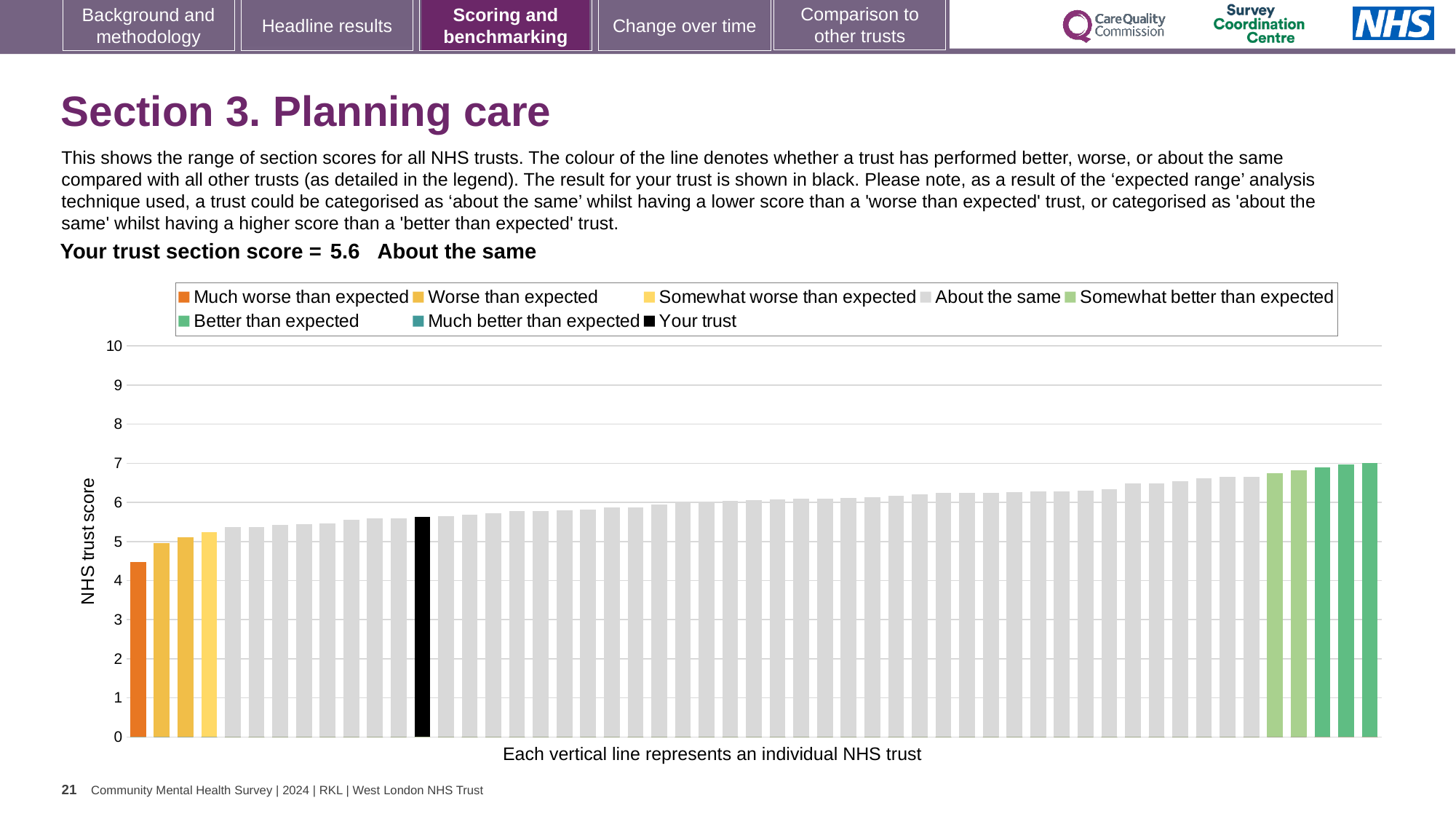
How many entries does the chart legend list? 8 Is the value of the leftmost (orange) bar greater or less than 5? less Which is larger: the leftmost bar or the rightmost bar? the rightmost bar What kind of chart is shown on the slide? bar chart What is the label on the vertical axis of the chart? NHS trust score Is the value of the black 'Your trust' bar greater or less than 5? greater What is the section score for your trust shown on the slide? 5.6 Which performance category is your trust placed in for Section 3. Planning care? About the same Is the value of the black 'Your trust' bar greater or less than 6? less Do the bar values rise or fall moving from left to right along the x axis? rise What colour is used for the 'Your trust' bar in the chart? black